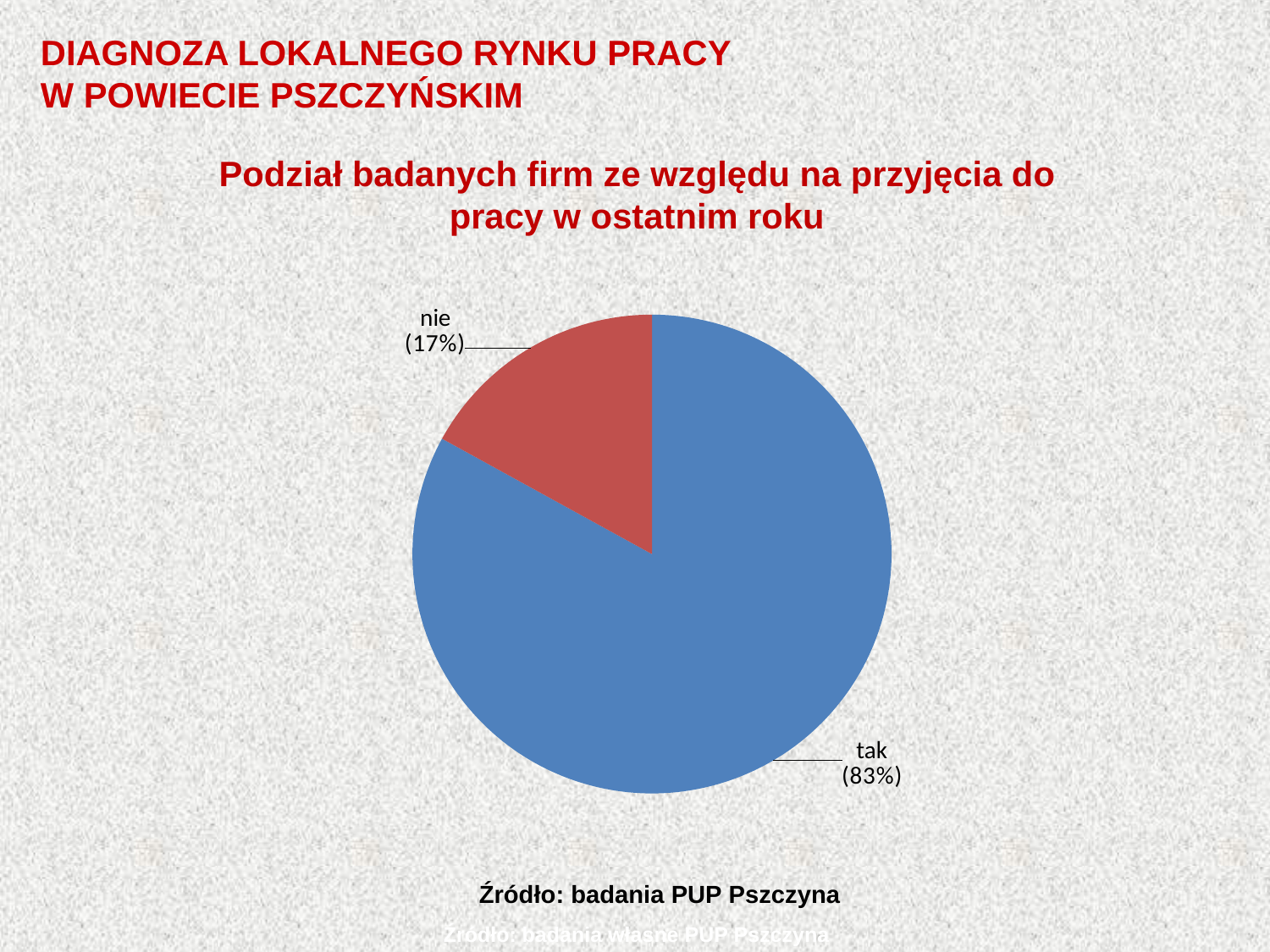
Which slice of the pie is the smallest? nie What is the difference in percentage points between the "tak" and "nie" slices? 66 What kind of chart is shown on the slide? pie chart Which slice of the pie is the largest? tak What share of the pie does the "nie" slice represent? 17% Which is larger, the "tak" slice or the "nie" slice? tak What share of the pie does the "tak" slice represent? 83% What is the title of the chart? Podział badanych firm ze względu na przyjęcia do pracy w ostatnim roku What colour is the "nie" slice? red How many slices does the pie chart have? 2